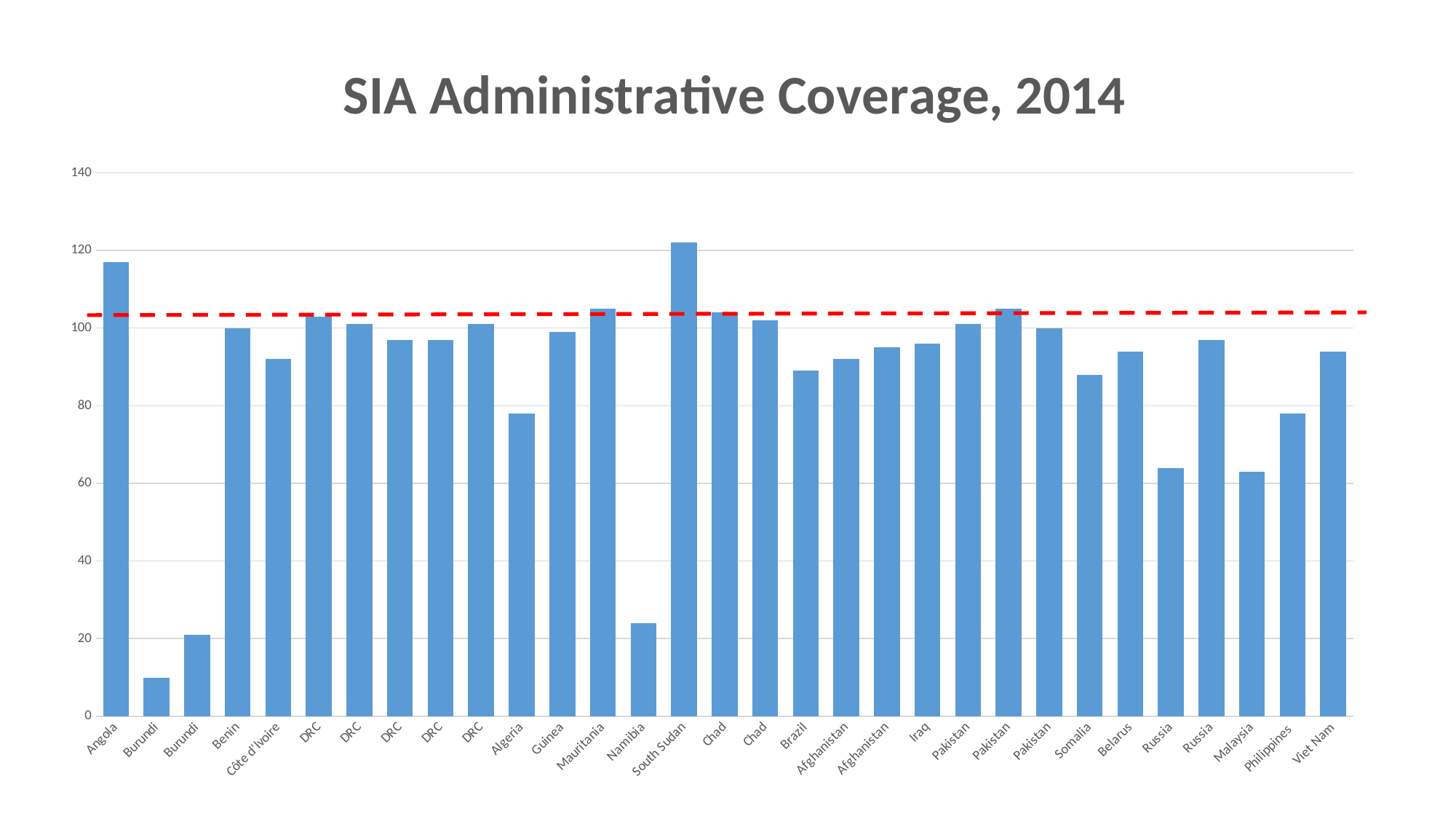
Is the value for Malaysia greater or less than 80? less What is the title of the chart? SIA Administrative Coverage, 2014 Is the value for Namibia greater or less than 40? less Is the value for Angola greater or less than 100? greater Which country has the lowest bar in the chart? Burundi What colour is the dashed horizontal line drawn across the chart? red What kind of chart is shown on the slide? bar chart Which is larger, the value for Angola or the value for Namibia? Angola Which country has the highest bar in the chart? South Sudan Which is larger, the value for Algeria or the value for Guinea? Guinea